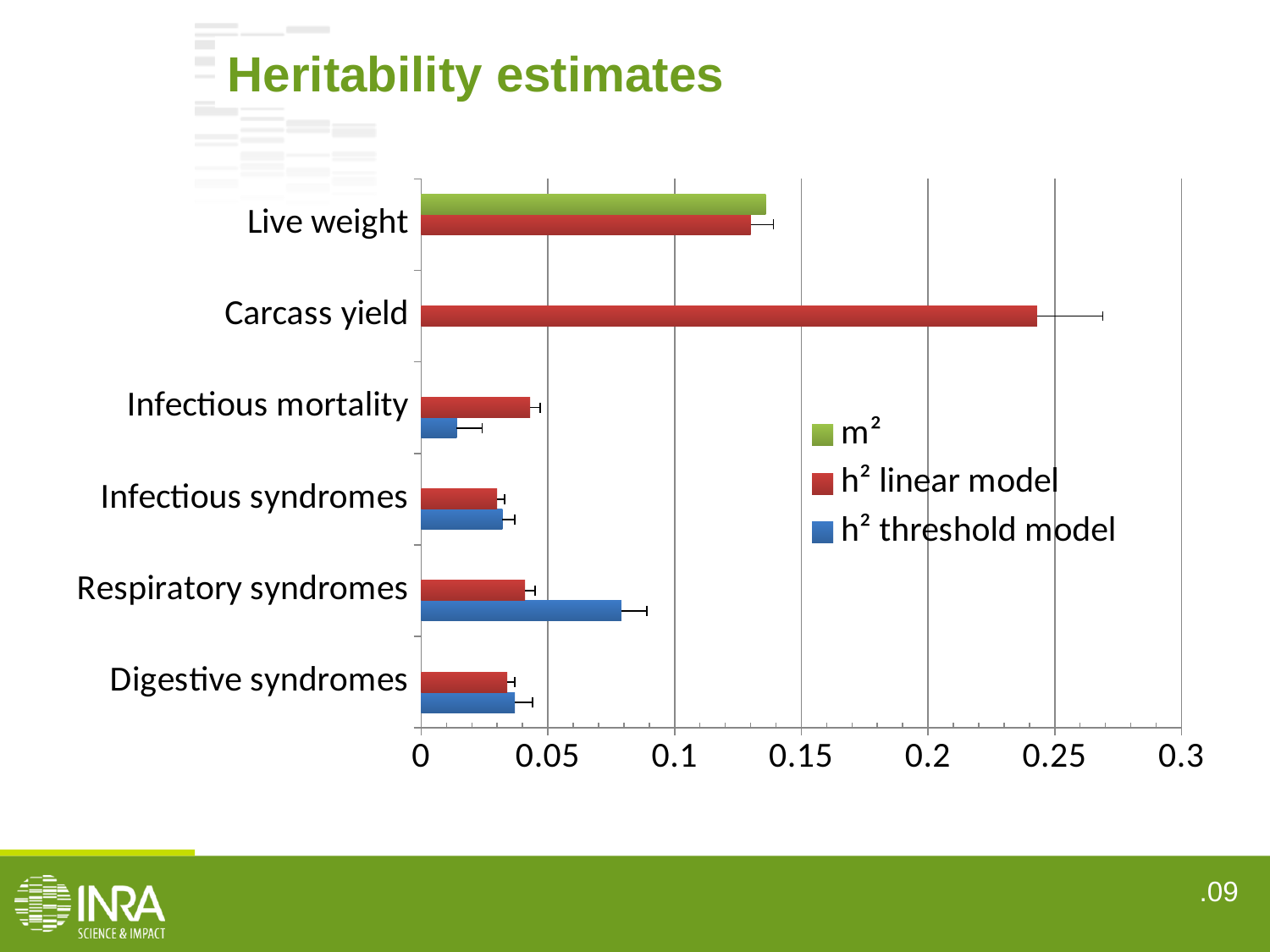
Which colour represents the m² series in the legend? green What is the title of the chart? Heritability estimates Is the m² value for Live weight greater or less than 0.1? greater Is the h² threshold model value for Respiratory syndromes greater or less than 0.05? greater What kind of chart is shown on the slide? bar chart Which category has the lowest value for the h² threshold model series? Infectious mortality For Respiratory syndromes, which is larger: the h² linear model value or the h² threshold model value? h² threshold model How many categories are shown on the vertical axis of the chart? 6 Which category has the highest value for the h² linear model series? Carcass yield How many series does the chart's legend list? 3 Is the h² linear model value for Infectious mortality greater or less than 0.05? less